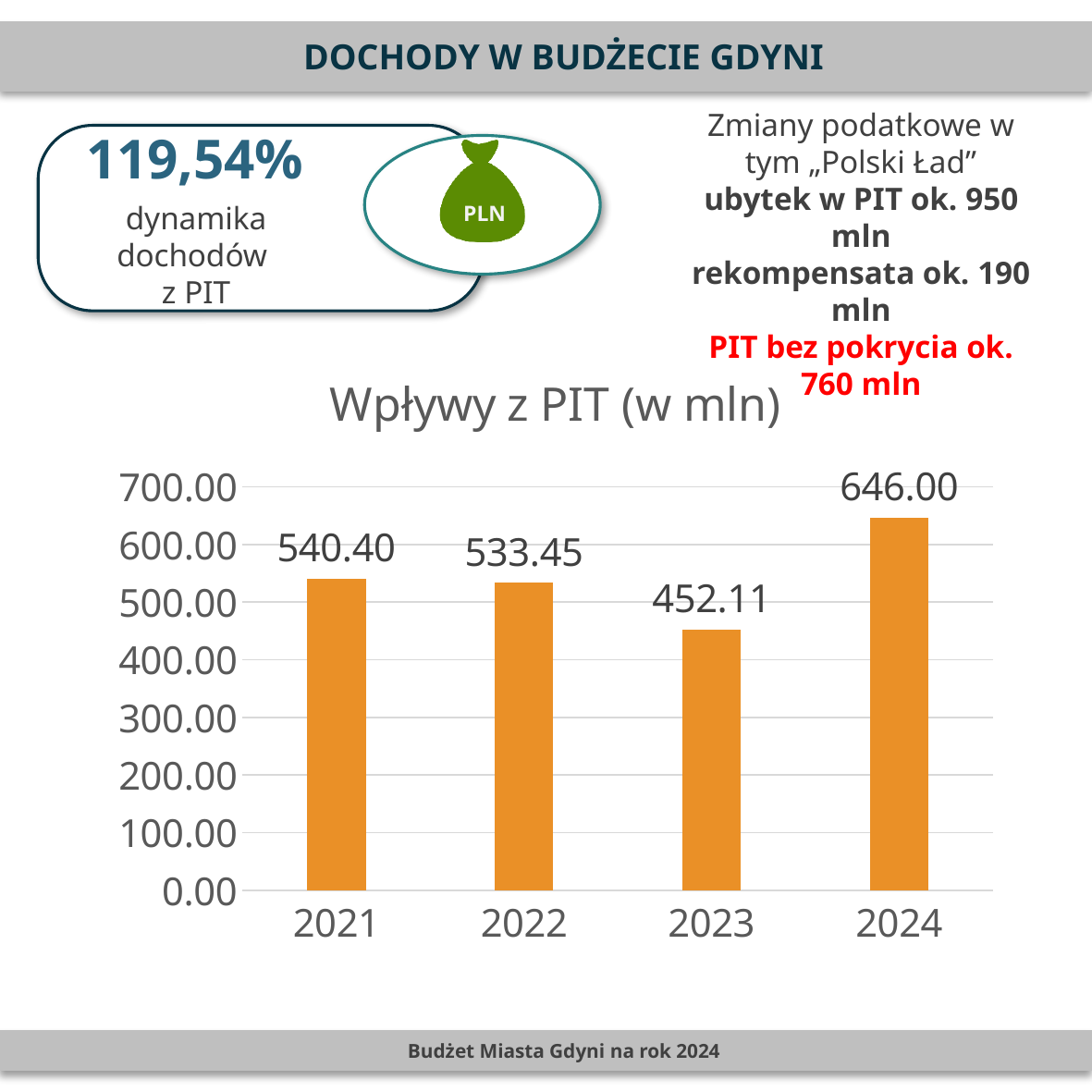
What is the difference between the values for 2024 and 2023? 193.89 What is the difference between the values for 2021 and 2022? 6.95 What is the value for 2023 in the chart? 452.11 How many years are shown in the chart? 4 Which year has the highest value in the chart? 2024 What kind of chart is shown on the slide? bar chart Is the value for 2023 greater or less than 500.00? less Which is larger, the value for 2021 or the value for 2023? 2021 What is the value for 2024 in the chart? 646.00 What is the value for 2021 in the chart? 540.40 Which year has the lowest value in the chart? 2023 What is the title of the chart? Wpływy z PIT (w mln)